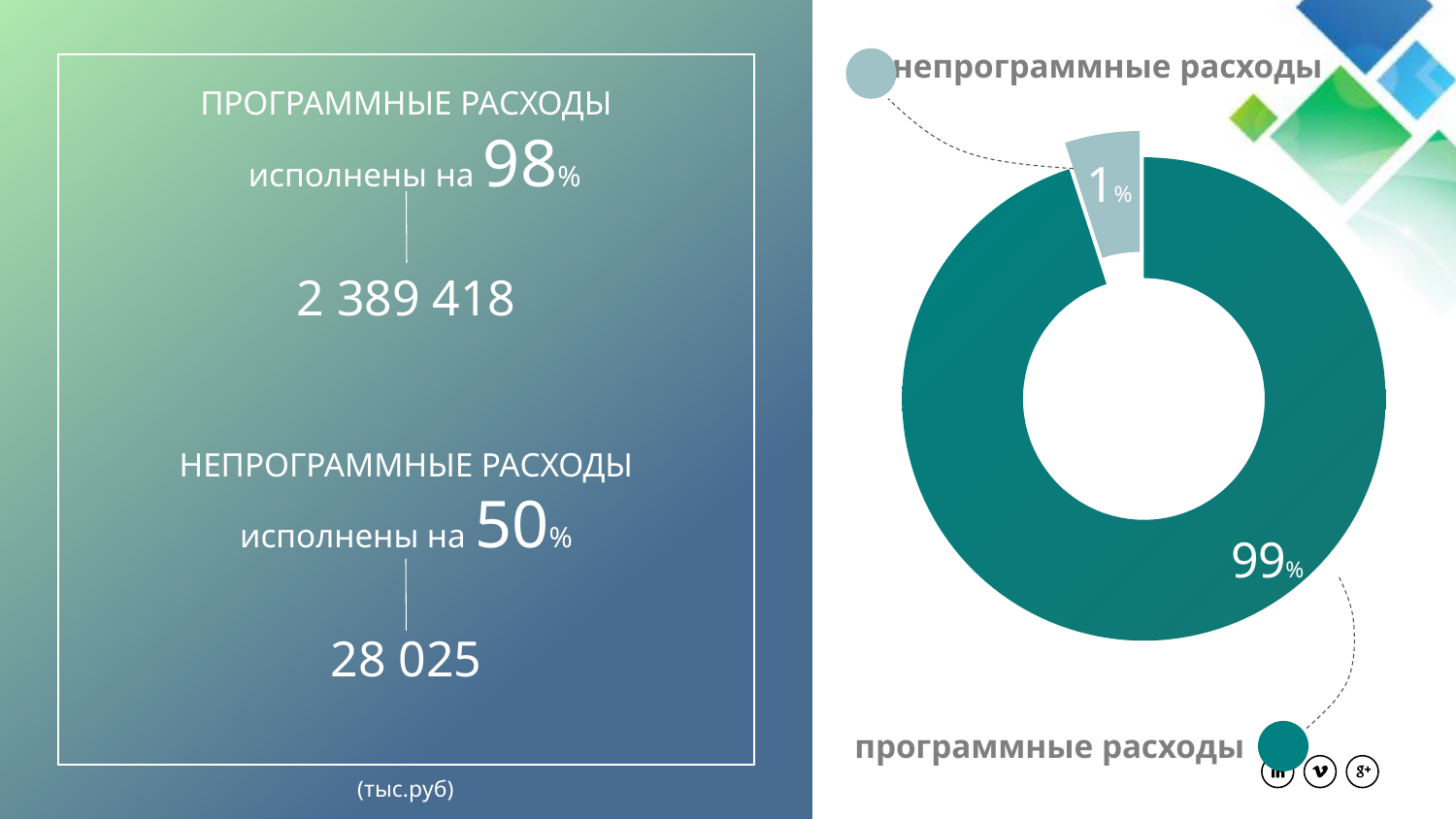
What colour is the "программные расходы" slice in the donut chart? Dark teal Which slice of the donut chart is the largest? программные расходы What share of the donut chart is labelled "непрограммные расходы"? 1% By how many percentage points does the "программные расходы" slice exceed the "непрограммные расходы" slice? 98 What kind of chart is shown on the right side of the slide? Donut (pie) chart What share of the donut chart is labelled "программные расходы"? 99% What colour is the "непрограммные расходы" slice in the donut chart? Light grey-blue Which slice of the donut chart is the smallest? непрограммные расходы Which is larger in the donut chart: "программные расходы" or "непрограммные расходы"? программные расходы How many slices does the donut chart have? 2 What is the combined share of the two slices in the donut chart? 100%